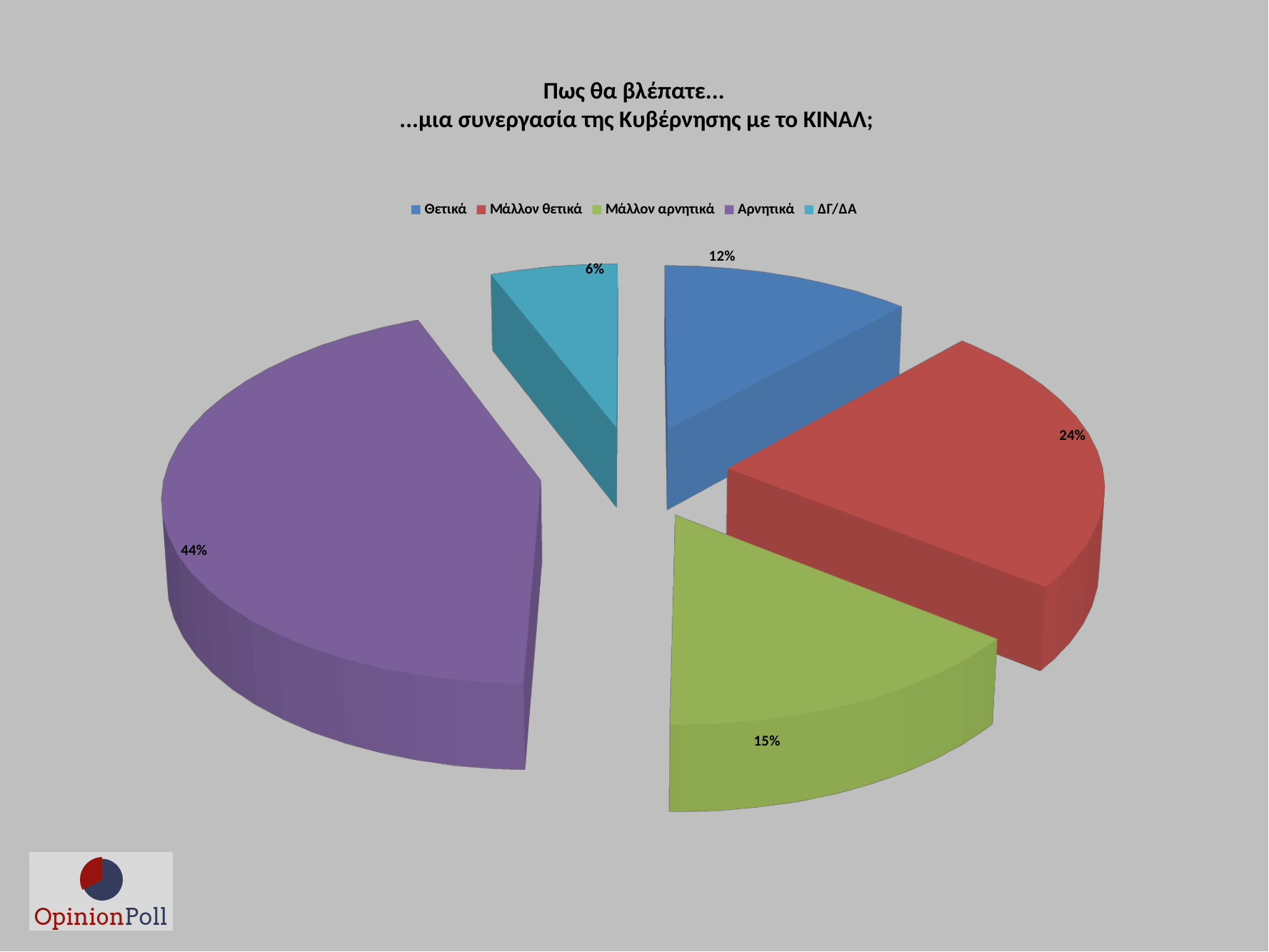
Which is larger, the share for Μάλλον θετικά or the share for Μάλλον αρνητικά? Μάλλον θετικά What percentage of respondents answered ΔΓ/ΔΑ? 6% How many categories does the legend list? 5 What is the difference in percentage points between Αρνητικά and Μάλλον θετικά? 20 What kind of chart is shown on the slide? Pie chart Which response has the largest share of the pie? Αρνητικά Which response has the smallest share of the pie? ΔΓ/ΔΑ What percentage of respondents answered Μάλλον αρνητικά? 15% What percentage of respondents answered Θετικά? 12% What colour is the slice for Αρνητικά? Purple What percentage of respondents answered Αρνητικά? 44% What percentage of respondents answered Μάλλον θετικά? 24%